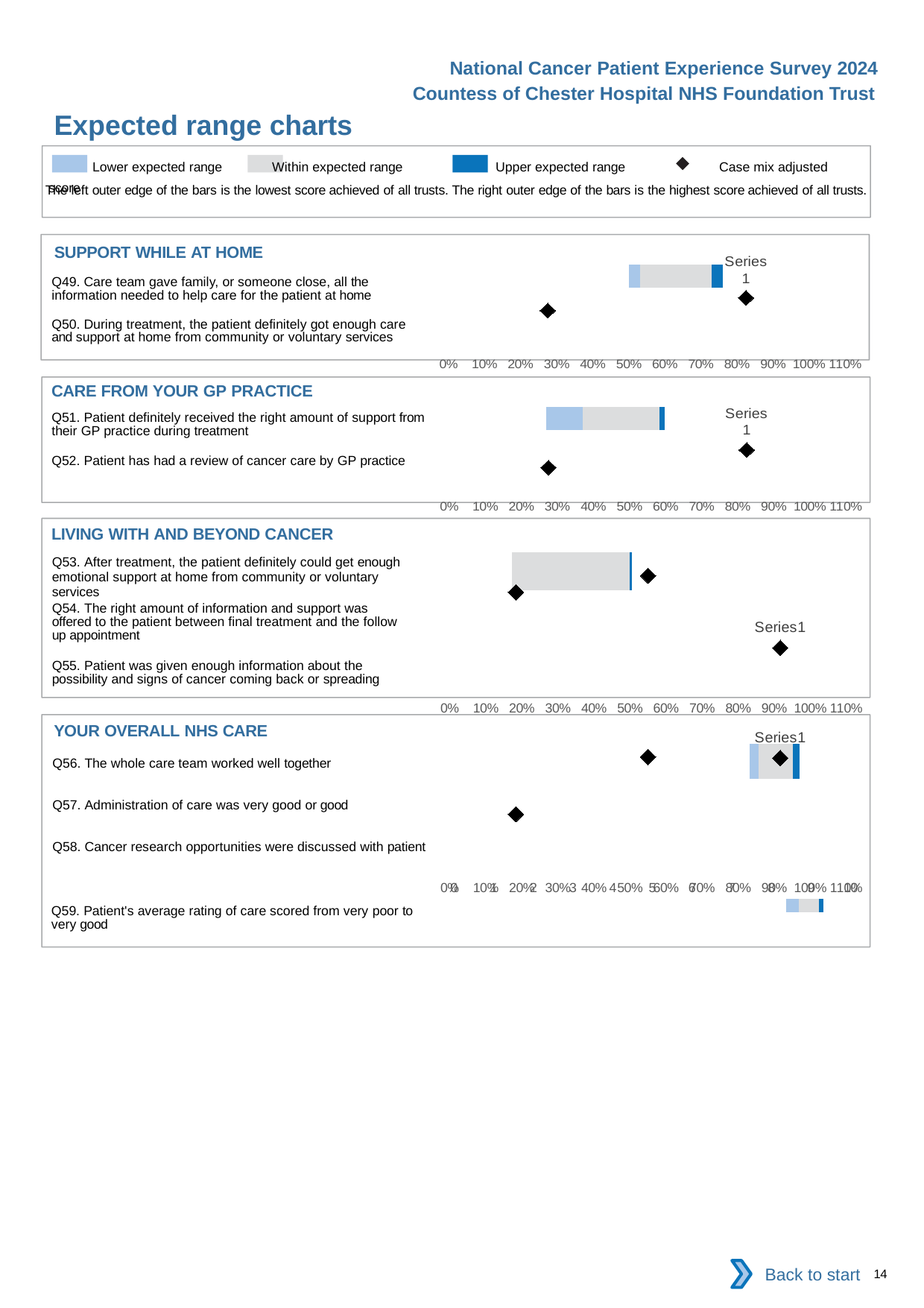
In the YOUR OVERALL NHS CARE chart, is the leftmost diamond marker greater or less than 30%? less How many questions are listed in the LIVING WITH AND BEYOND CANCER section? 3 In the CARE FROM YOUR GP PRACTICE chart, is the diamond marker below the Series 1 label greater or less than 70%? greater According to the legend, what does the diamond marker represent? Case mix adjusted score How many questions are listed in the YOUR OVERALL NHS CARE section? 4 What is the highest value shown on the x axis of the CARE FROM YOUR GP PRACTICE chart? 110% In the SUPPORT WHILE AT HOME chart, is the diamond marker below the Series 1 label greater or less than 70%? greater How many entries does the legend at the top of the slide list? 4 How many questions are listed in the SUPPORT WHILE AT HOME section? 2 What kind of chart is used in the SUPPORT WHILE AT HOME section? Bar chart